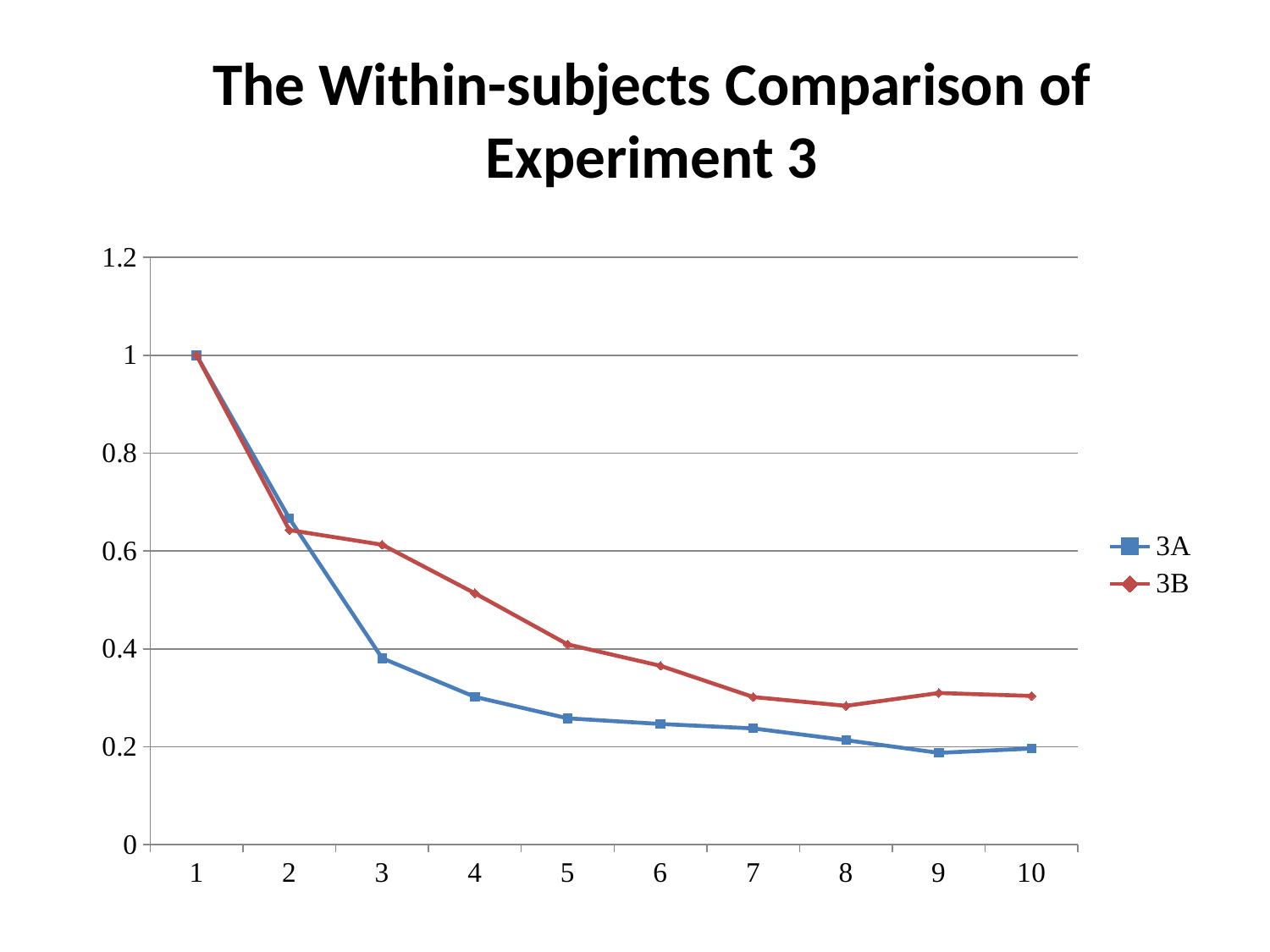
Is the value for 3B at x = 10 greater or less than 0.2? greater How many series does the legend list? 2 At x = 5, which series has the larger value, 3A or 3B? 3B At which x value does series 3A reach its highest value? 1 What is the value of series 3A at x = 1? 1 How many points are plotted along the x axis for each series? 10 What is the value of series 3B at x = 1? 1 Is the value for 3A at x = 5 greater or less than 0.4? less Do the values of series 3A generally rise or fall from x = 1 to x = 10? fall What kind of chart is shown on the slide? line chart Is the value for 3B at x = 4 greater or less than 0.4? greater What is the title of the chart? The Within-subjects Comparison of Experiment 3